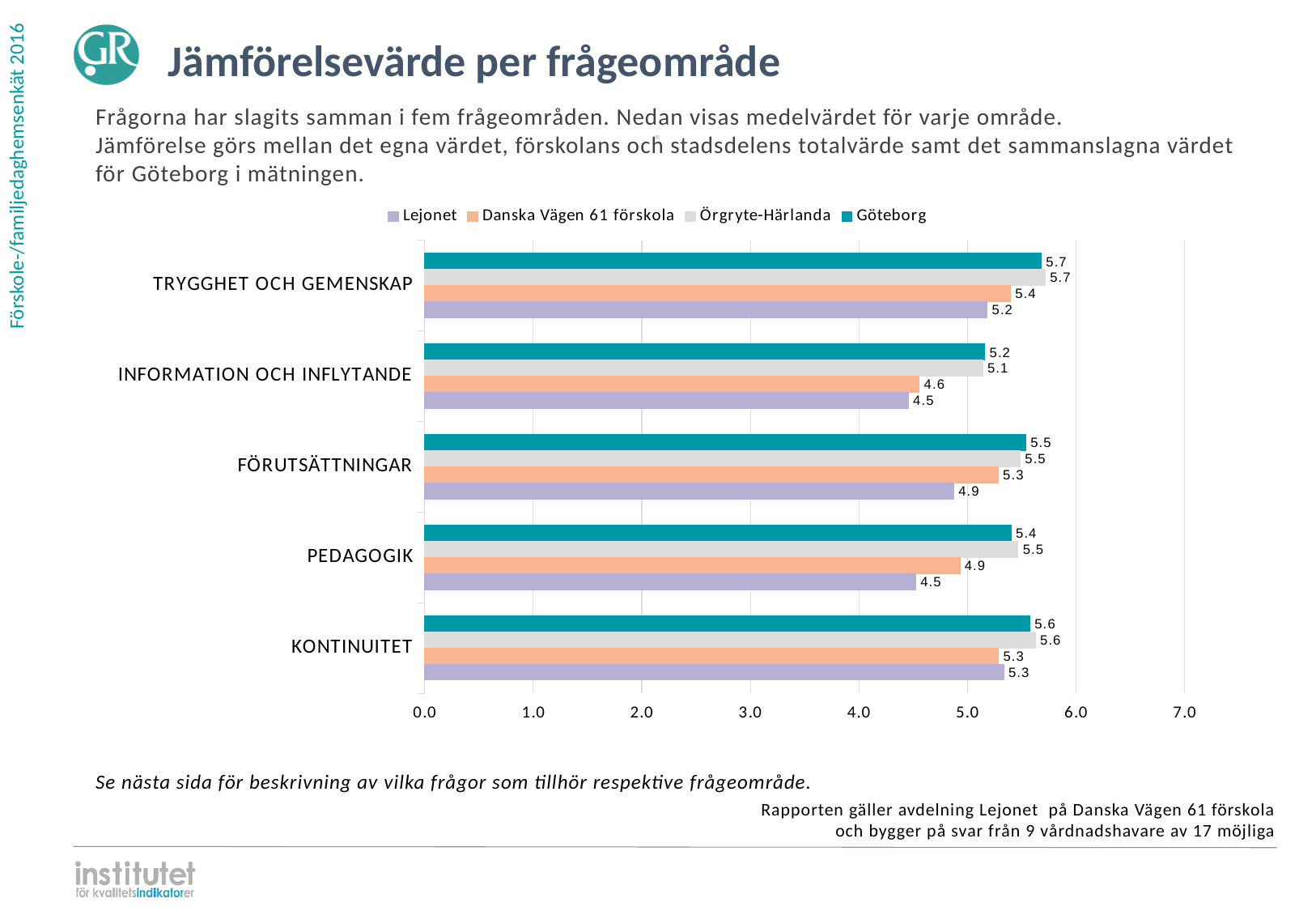
What is the value for Danska Vägen 61 förskola in the PEDAGOGIK category? 4.9 What is the value for Lejonet in the TRYGGHET OCH GEMENSKAP category? 5.2 What is the difference between the Göteborg value and the Lejonet value in the FÖRUTSÄTTNINGAR category? 0.6 In the PEDAGOGIK category, which is larger: the value for Örgryte-Härlanda or the value for Lejonet? Örgryte-Härlanda How many question areas (categories) are shown on the chart? 5 In which category does Lejonet have its highest value? KONTINUITET Which series is shown in teal on the chart? Göteborg In which category does Danska Vägen 61 förskola have its lowest value? INFORMATION OCH INFLYTANDE What is the value for Göteborg in the INFORMATION OCH INFLYTANDE category? 5.2 How many series does the legend list? 4 What is the value for Örgryte-Härlanda in the KONTINUITET category? 5.6 What kind of chart is shown on the slide? Bar chart